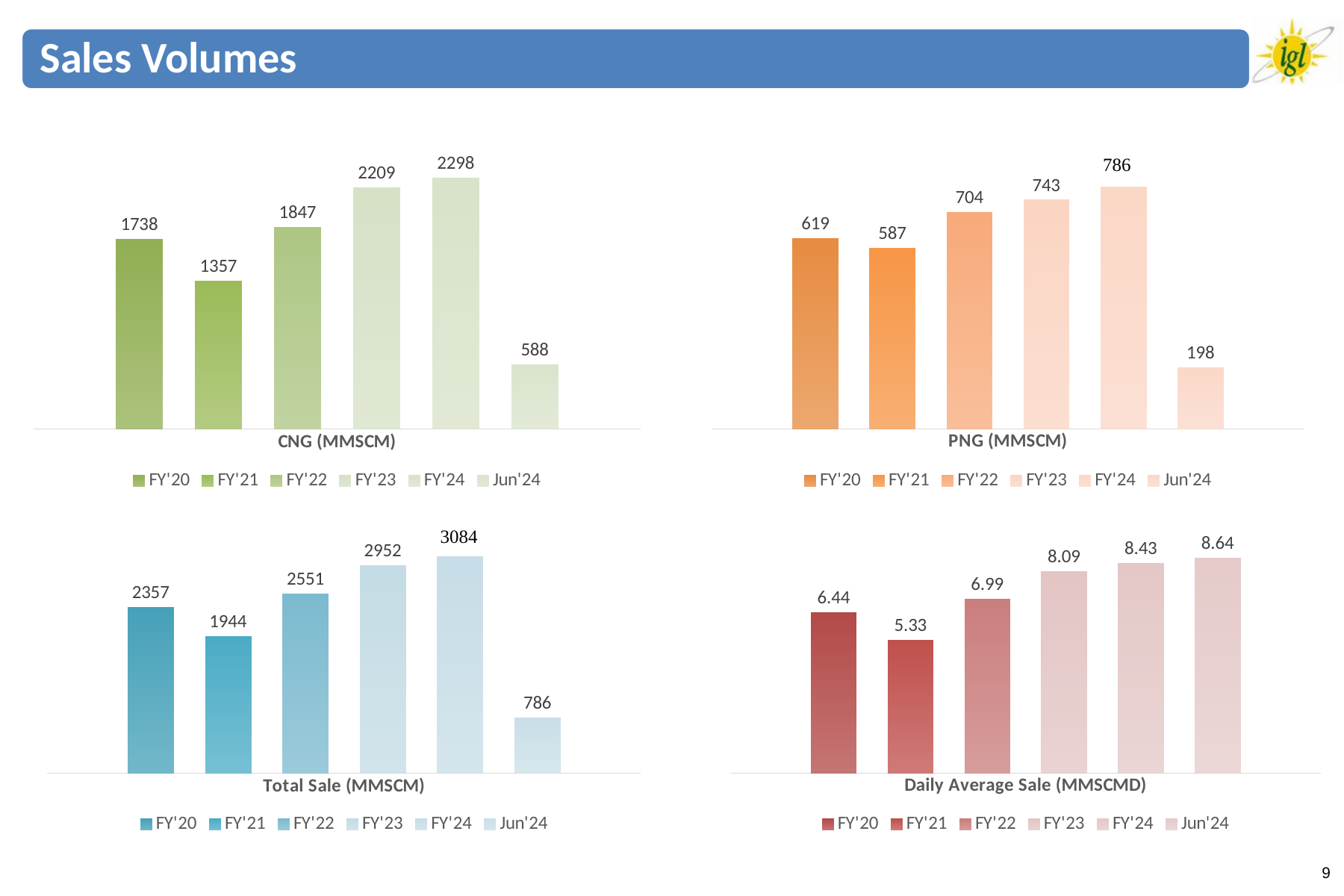
In the CNG (MMSCM) chart, which period has the lowest value? Jun'24 How many entries does the legend of the PNG (MMSCM) chart list? 6 In the Total Sale (MMSCM) chart, what is the difference between FY'24 and FY'20? 727 In the Daily Average Sale (MMSCMD) chart, which period has the highest value? Jun'24 How many bars are plotted in the CNG (MMSCM) chart? 6 In the Daily Average Sale (MMSCMD) chart, which is larger, FY'20 or FY'21? FY'20 In the Total Sale (MMSCM) chart, what is the value for Jun'24? 786 What type of chart is the Total Sale (MMSCM) chart? Bar chart In the PNG (MMSCM) chart, what is the value for FY'21? 587 In the PNG (MMSCM) chart, what is the difference between the FY'24 and FY'23 values? 43 In the Daily Average Sale (MMSCMD) chart, do the values rise or fall from FY'21 to Jun'24? Rise In the CNG (MMSCM) chart, what is the value for FY'24? 2298